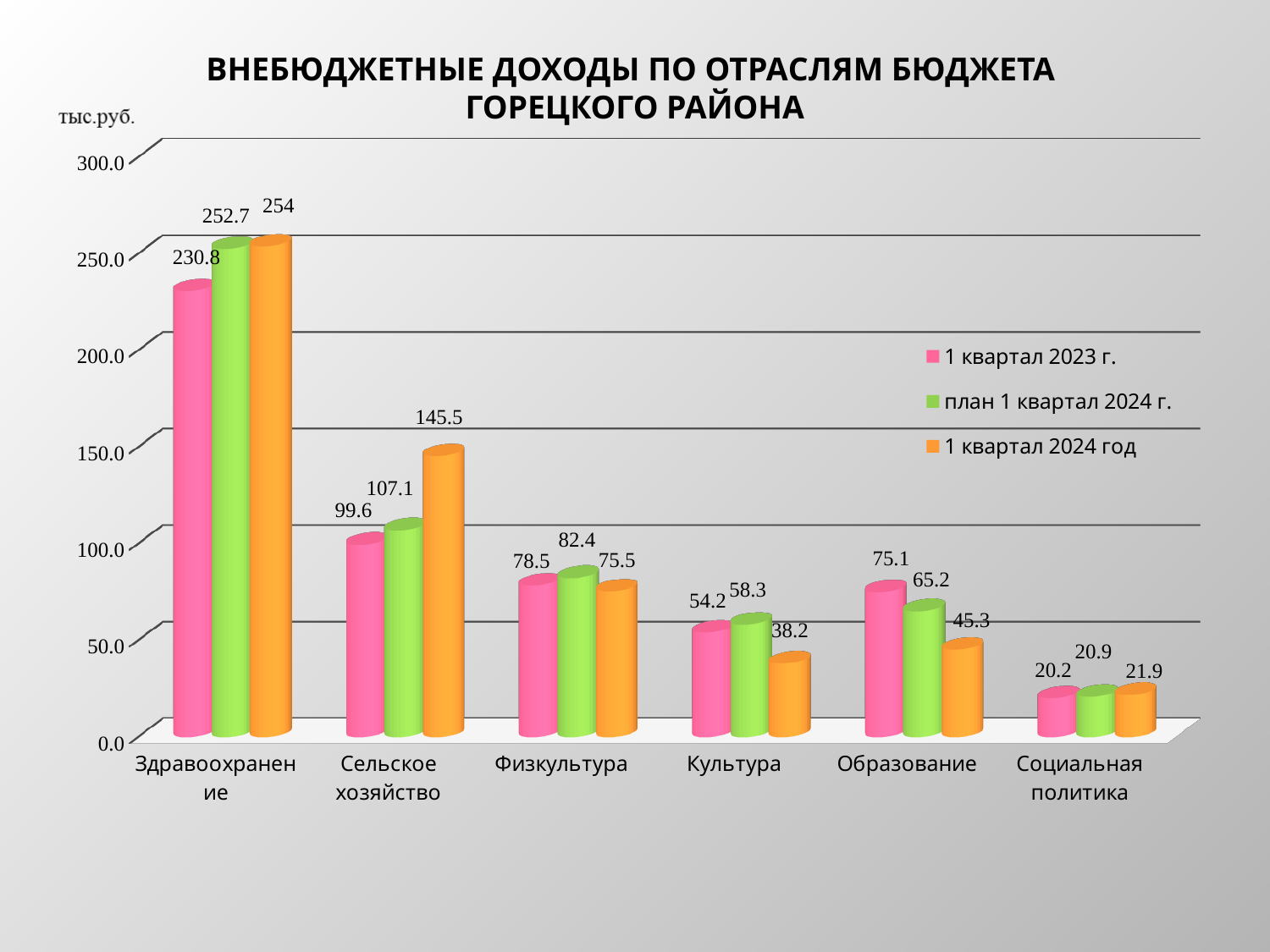
What unit is shown at the top of the vertical axis? тыс.руб. What is the value for Здравоохранение in the series 1 квартал 2023 г.? 230.8 What is the value for Сельское хозяйство in the series 1 квартал 2024 год? 145.5 What kind of chart is shown on the slide? bar chart How many series does the legend list? 3 What is the value for Культура in the series план 1 квартал 2024 г.? 58.3 For Образование, which is larger: the value for 1 квартал 2023 г. or the value for 1 квартал 2024 год? 1 квартал 2023 г. Which category has the highest value in the series 1 квартал 2024 год? Здравоохранение Which category has the lowest value in the series 1 квартал 2023 г.? Социальная политика How many categories are shown on the x axis? 6 Is the value for Физкультура in the series план 1 квартал 2024 г. greater or less than 100.0? less What is the difference between the 1 квартал 2024 год value and the 1 квартал 2023 г. value for Сельское хозяйство? 45.9